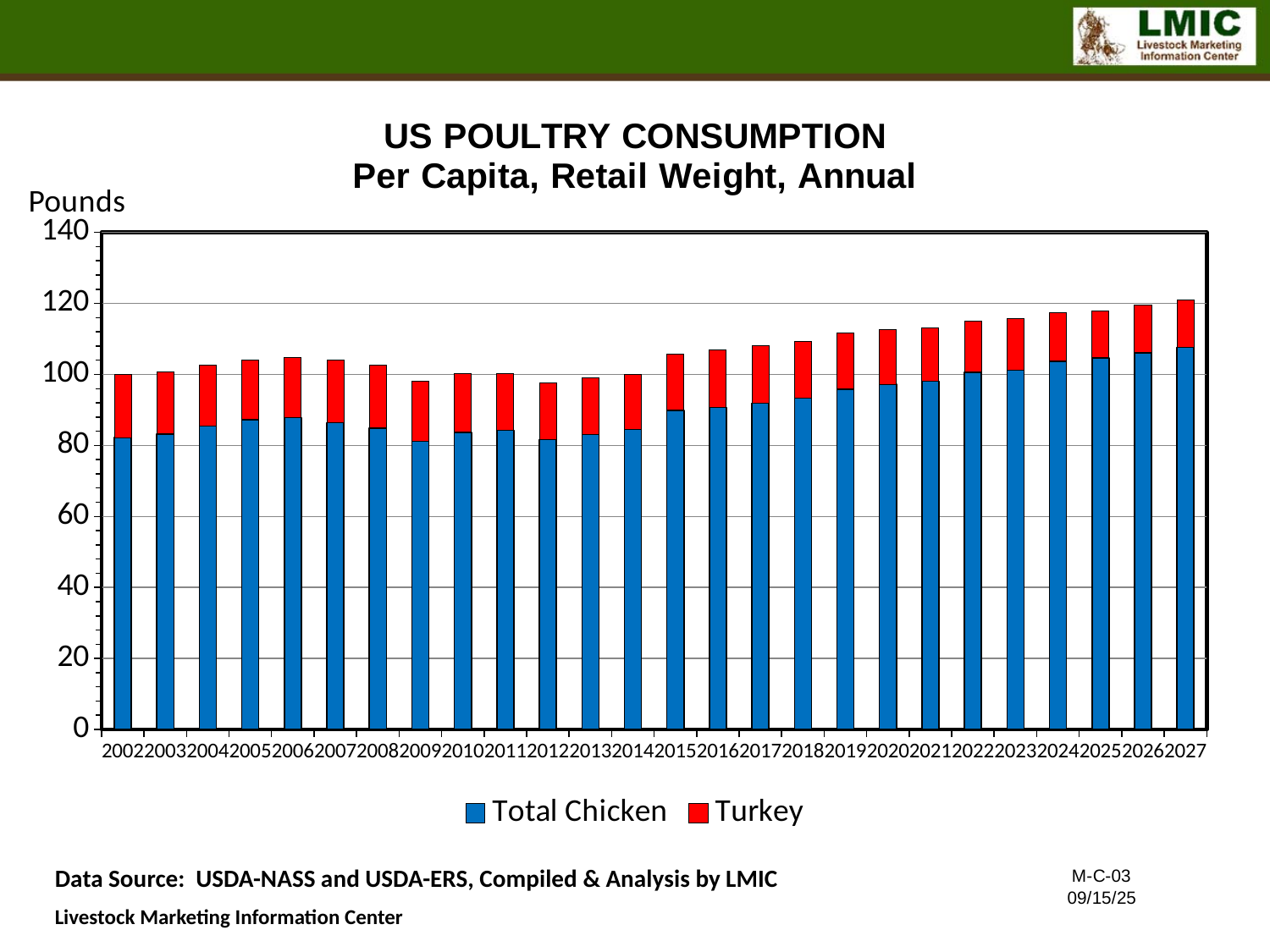
Do the total stacked bars rise or fall from 2015 to 2027? Rise Which year has the highest Total Chicken value? 2027 Which year has the highest total poultry consumption (tallest stacked bar)? 2027 Which is larger, the Total Chicken value for 2002 or for 2027? 2027 How many years are shown along the x axis? 26 What kind of chart is shown on the slide? Stacked bar chart What unit is labelled on the y axis? Pounds Is the Total Chicken value for 2012 greater or less than 100? less Which is larger, the Turkey value for 2002 or for 2027? 2002 How many series does the legend list? 2 Is the total stacked bar for 2020 greater or less than 100? greater Is the Total Chicken value for 2027 greater or less than 100? greater